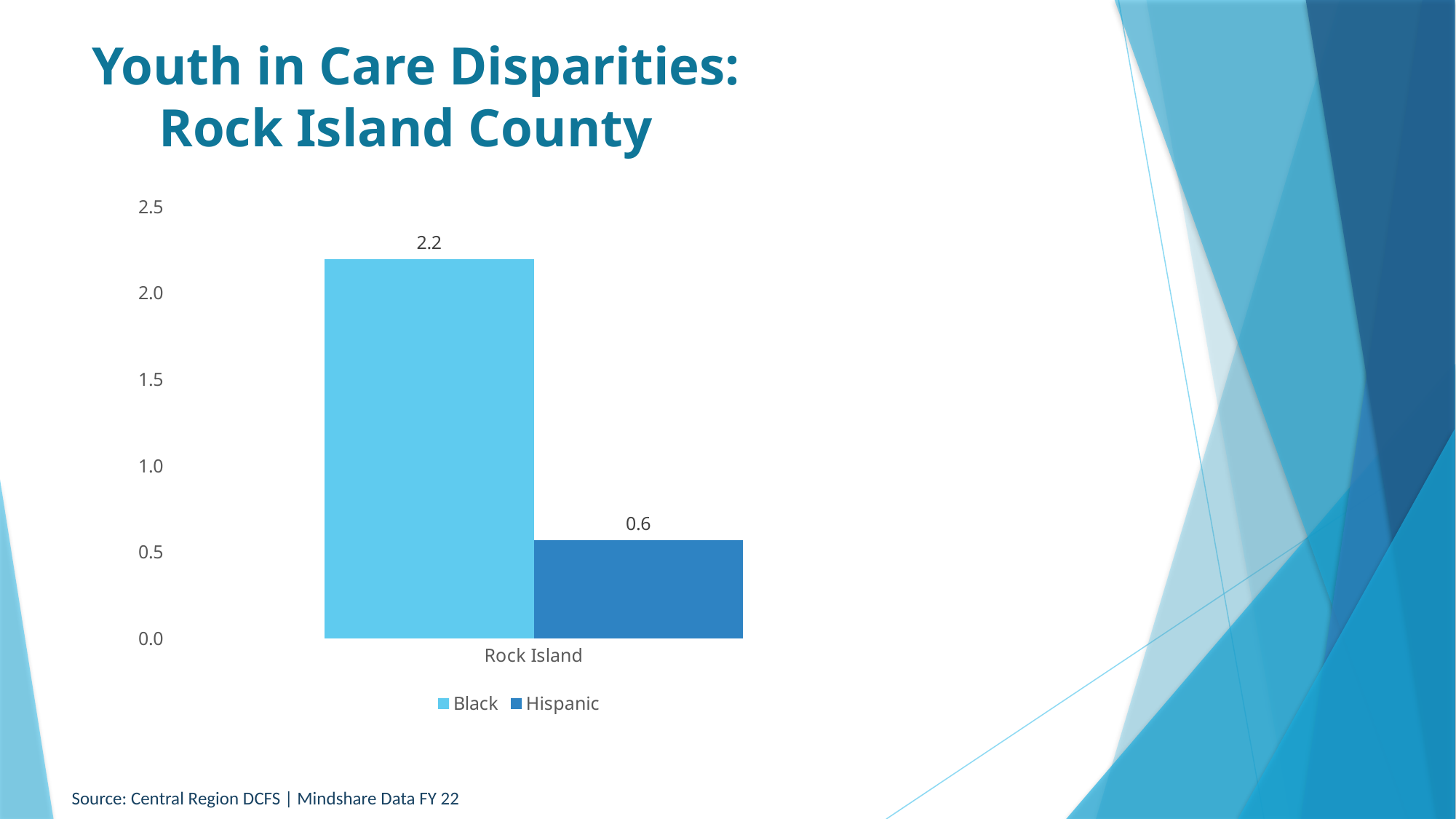
What is the highest value shown on the y axis? 2.5 Which series has the highest value in the chart? Black How many series does the legend list? 2 What kind of chart is shown on the slide? Bar chart What is the value for Hispanic in Rock Island? 0.6 Which series has the higher value for Rock Island, Black or Hispanic? Black Is the value for Hispanic in Rock Island greater or less than 1.0? less Which series has the lowest value in the chart? Hispanic Is the value for Black in Rock Island greater or less than 2.0? greater What is the value for Black in Rock Island? 2.2 How many categories are shown on the x axis? 1 What is the difference between the Black and Hispanic values for Rock Island? 1.6